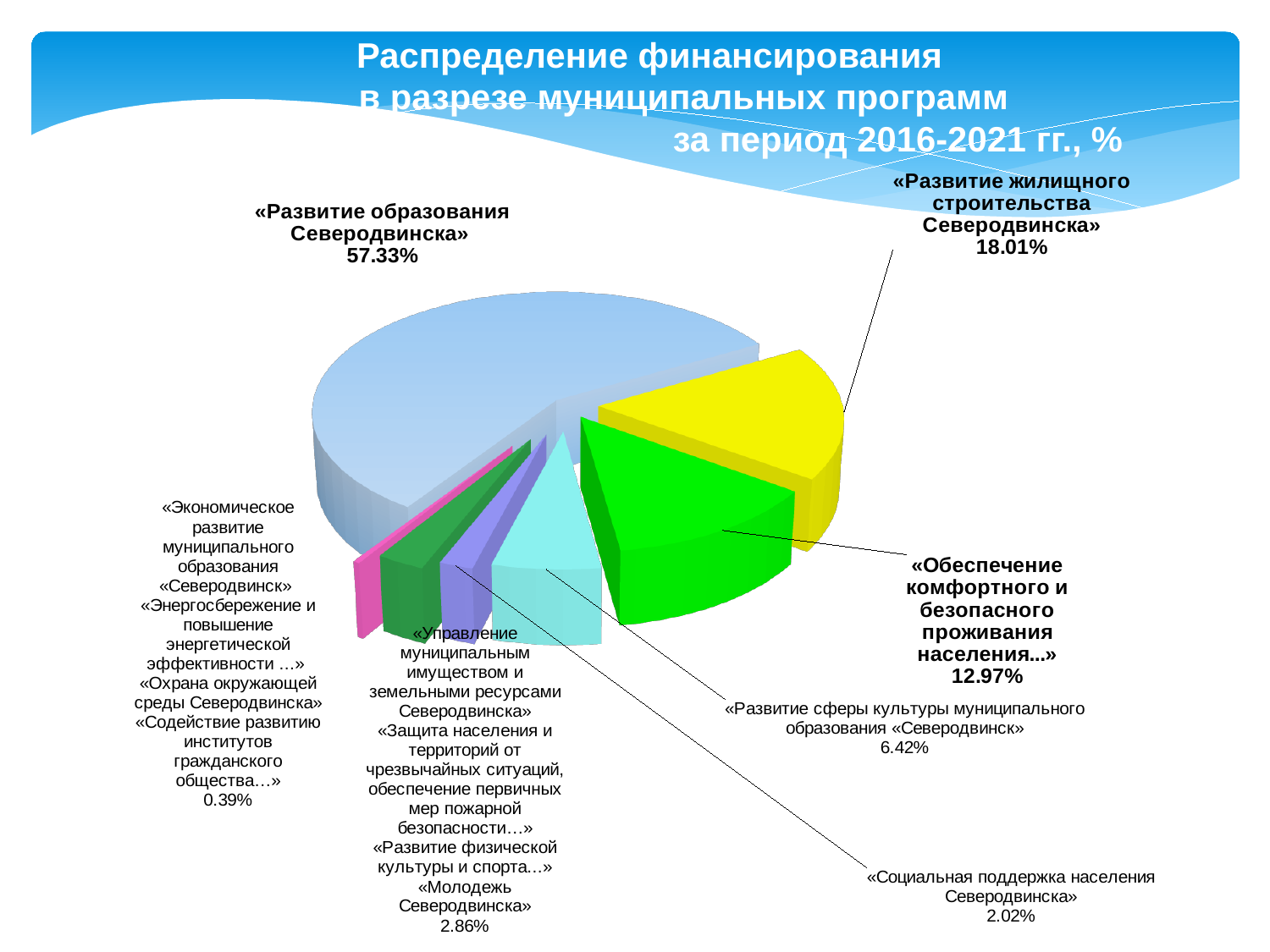
What colour is the slice for «Развитие жилищного строительства Северодвинска»? Yellow What share of funding does «Развитие образования Северодвинска» receive? 57.33% Which program has the largest share of funding? «Развитие образования Северодвинска» What percentage is shown for «Развитие сферы культуры муниципального образования «Северодвинск»? 6.42% What percentage is shown for «Социальная поддержка населения Северодвинска»? 2.02% What is the smallest percentage shown on the chart? 0.39% How many slices does the pie chart have? 7 What percentage is shown for «Обеспечение комфортного и безопасного проживания населения...»? 12.97% Which has a larger share: «Обеспечение комфортного и безопасного проживания населения...» or «Развитие сферы культуры муниципального образования «Северодвинск»? «Обеспечение комфортного и безопасного проживания населения...» What percentage is shown for «Развитие жилищного строительства Северодвинска»? 18.01% What is the difference between the shares of «Развитие образования Северодвинска» and «Развитие жилищного строительства Северодвинска»? 39.32% What kind of chart is shown on the slide? Pie chart